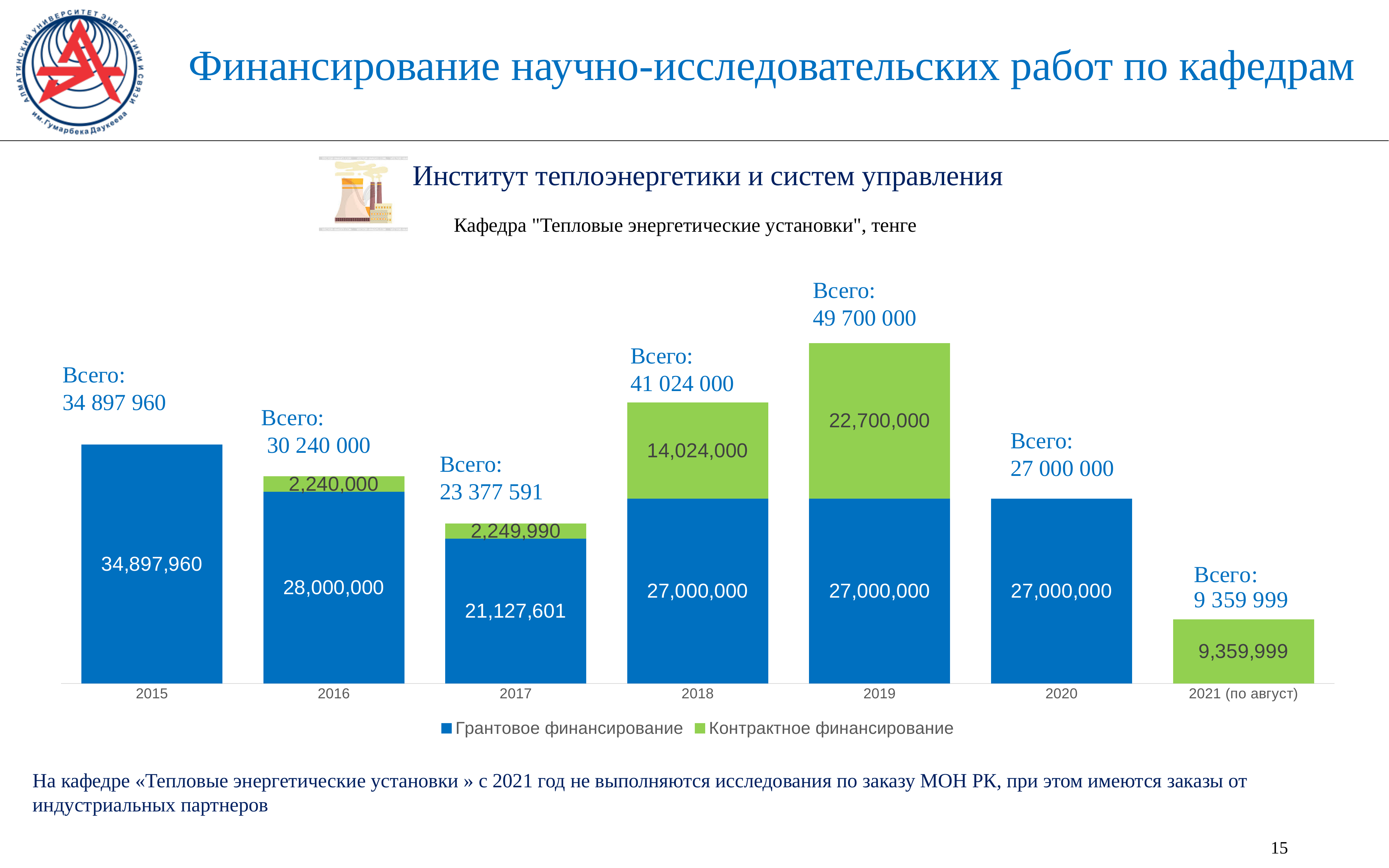
What is the value of Контрактное финансирование for 2021 (по август)? 9,359,999 What kind of chart is shown on the slide? Stacked bar chart Which year has the lowest total (Всего) funding? 2021 (по август) Which year has the highest total (Всего) funding? 2019 How many series does the legend list? 2 What is the value of Грантовое финансирование for 2017? 21,127,601 Which is larger: Грантовое финансирование in 2016 or in 2017? 2016 What is the value of Контрактное финансирование for 2019? 22,700,000 What is the total (Всего) funding for 2018? 41 024 000 How many years (categories) are shown on the x axis? 7 What is the difference between Контрактное финансирование in 2019 and in 2018? 8,676,000 What is the value of Грантовое финансирование for 2015? 34,897,960